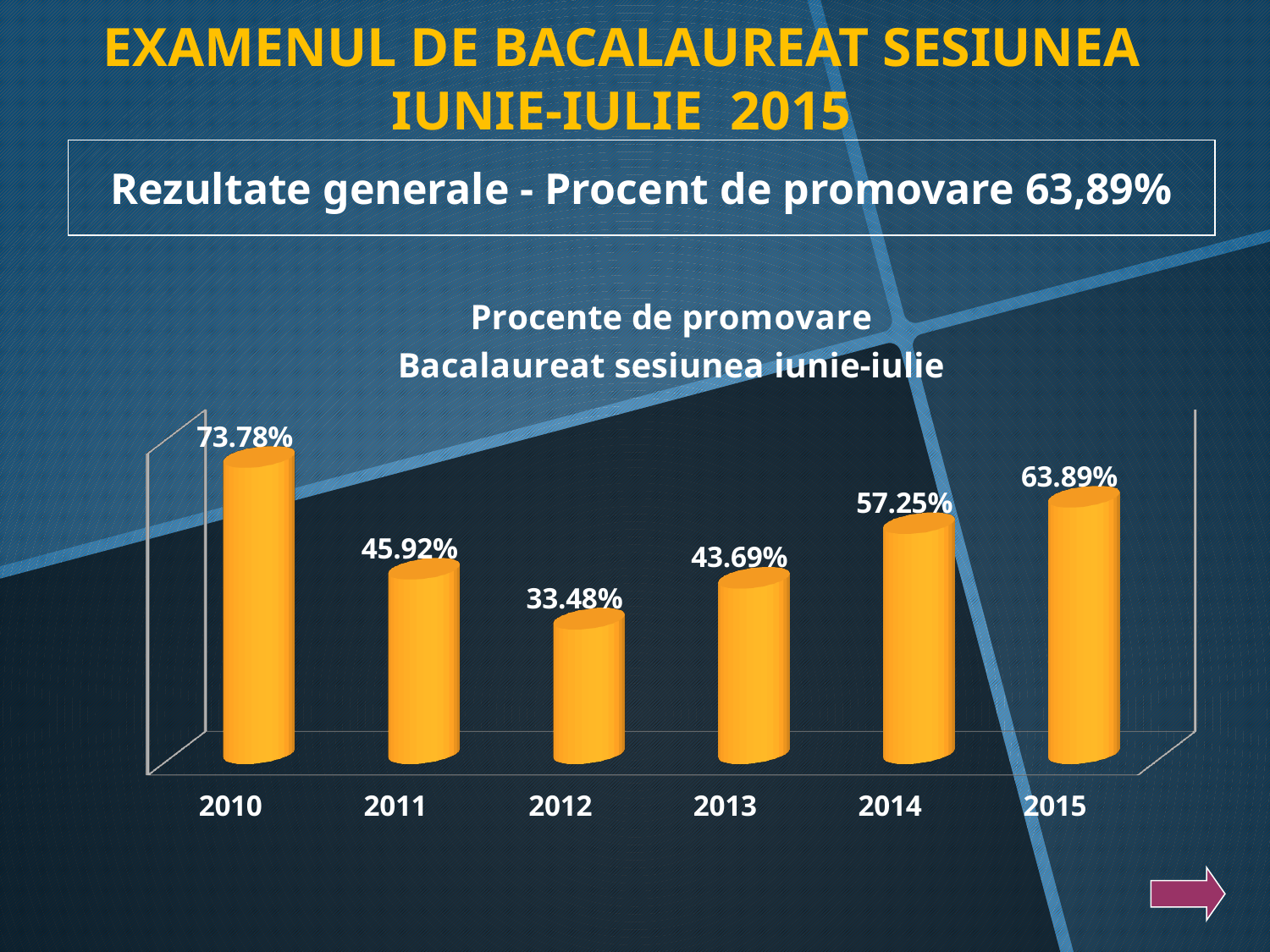
Does the pass rate rise or fall from 2012 to 2015? Rise Which year has the highest pass rate? 2010 What kind of chart is shown on the slide? Bar chart How many years are shown on the chart? 6 What is the difference between the pass rates for 2010 and 2012? 40.30% What is the title of the chart? Procente de promovare Bacalaureat sesiunea iunie-iulie Which year has the lowest pass rate? 2012 What is the pass rate shown for 2012? 33.48% What is the pass rate shown for 2010? 73.78% What is the pass rate shown for 2015? 63.89% Which year has a higher pass rate, 2011 or 2013? 2011 What is the difference between the pass rates for 2015 and 2014? 6.64%